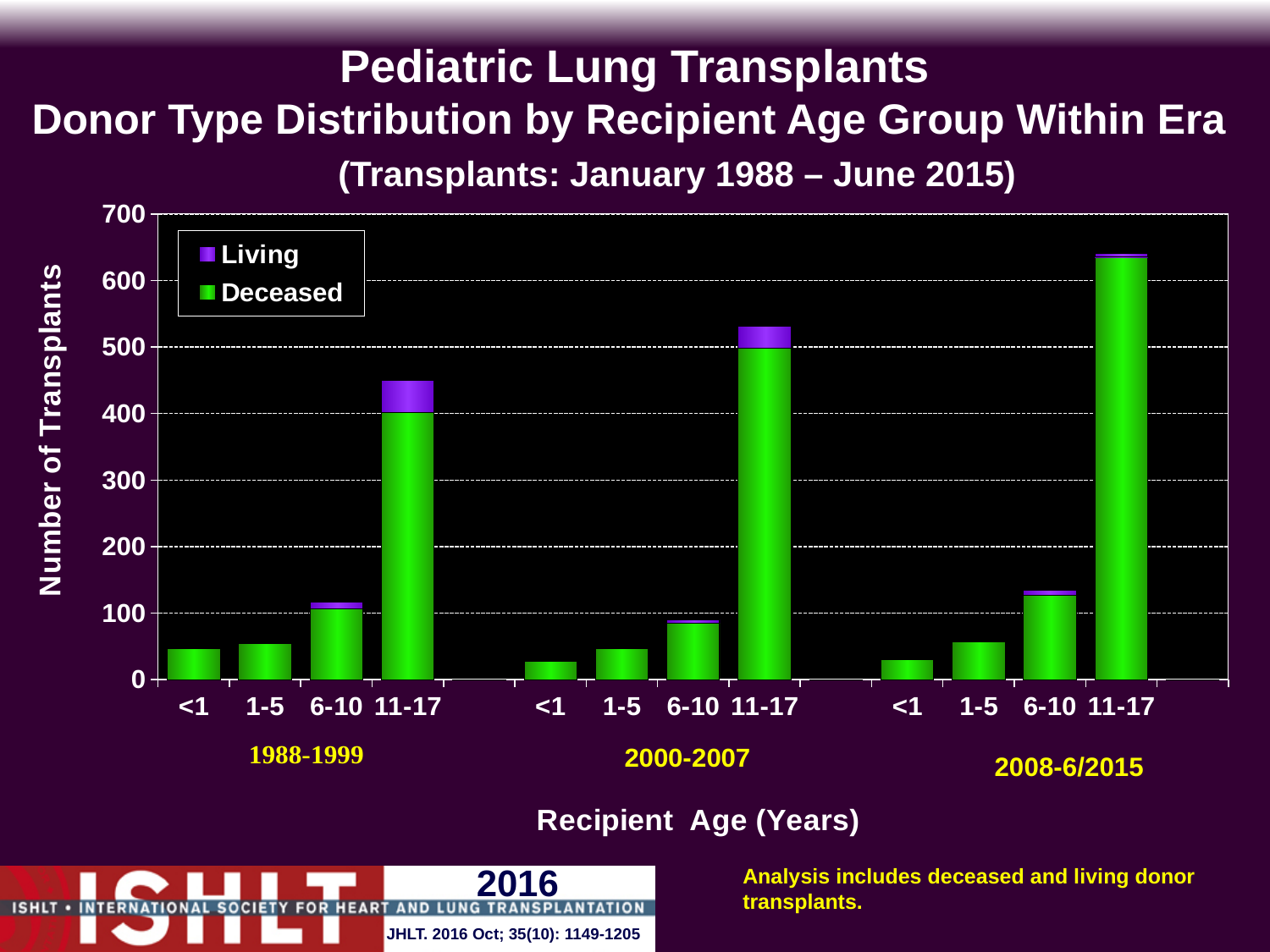
Is the total number of transplants for the 11-17 age group in 1988-1999 greater or less than 500? less What kind of chart is shown on the slide? Stacked bar chart How many bars are plotted in the chart? 12 Which is larger: the total for the 6-10 age group in 1988-1999 or the total for the 6-10 age group in 2000-2007? 6-10 in 1988-1999 Is the total number of transplants for the 6-10 age group in 2008-6/2015 greater or less than 100? greater Within the 2000-2007 era, which recipient age group has the lowest number of transplants? <1 Is the total number of transplants for the 11-17 age group in 2000-2007 greater or less than 500? greater Within each era, do the bar totals rise or fall as the recipient age group increases from <1 to 11-17? rise Which bar is the tallest in the chart? 11-17 in 2008-6/2015 How many series does the legend list? 2 What colour represents the Living donor series in the legend? Purple